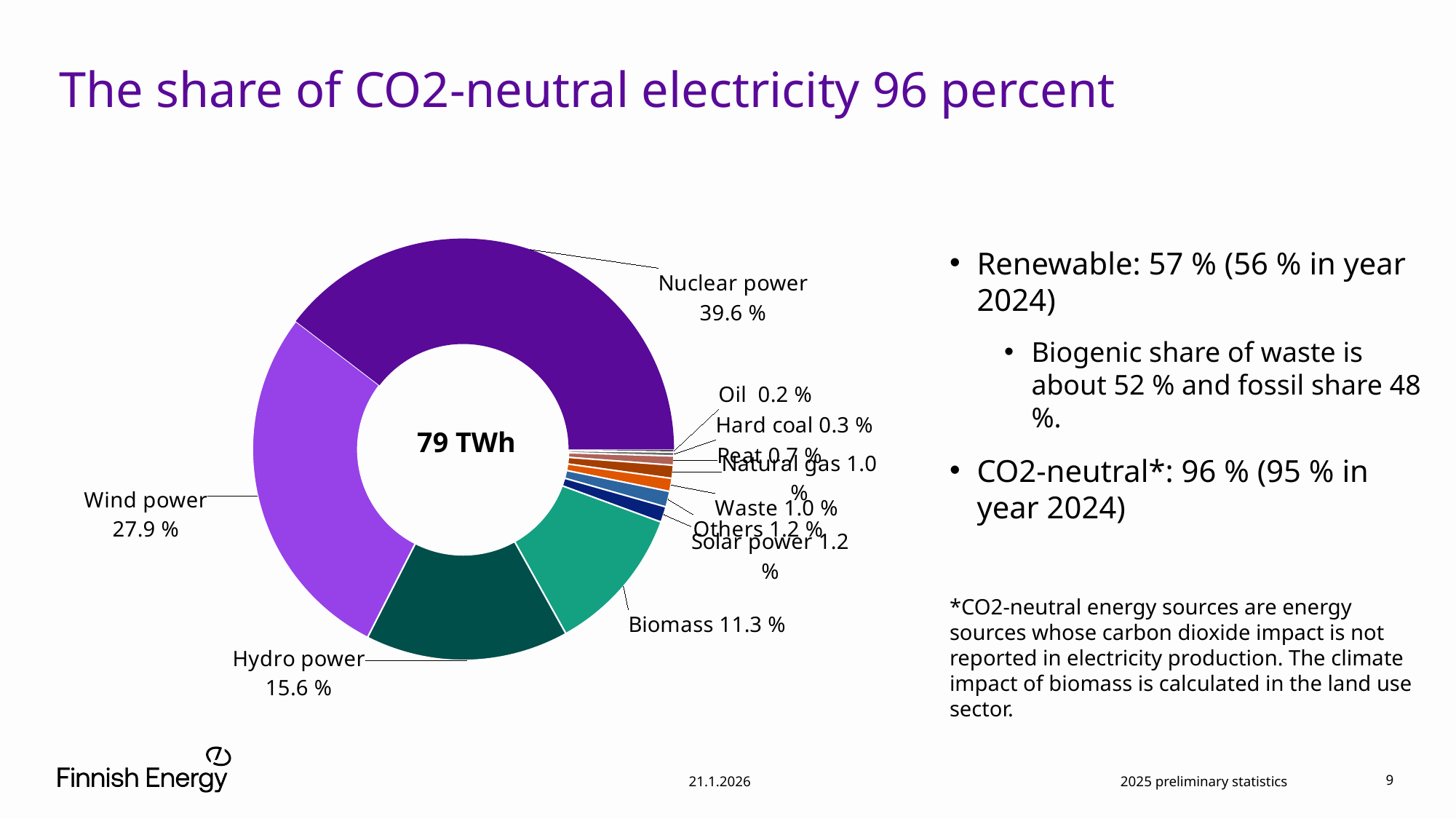
What is the difference in percentage points between the Nuclear power and Wind power shares? 11.7 Which energy source has the largest share in the chart? Nuclear power What is the combined share of Wind power and Hydro power? 43.5 % What share does Biomass have in the chart? 11.3 % What share does Hard coal have in the chart? 0.3 % What kind of chart is shown on the slide? Pie (donut) chart Which energy source has the smallest share in the chart? Oil What share does Hydro power have in the chart? 15.6 % What share of electricity does Wind power have in the chart? 27.9 % Which has a larger share, Hydro power or Biomass? Hydro power What total electricity amount is shown in the centre of the chart? 79 TWh What share of electricity does Nuclear power have in the chart? 39.6 %